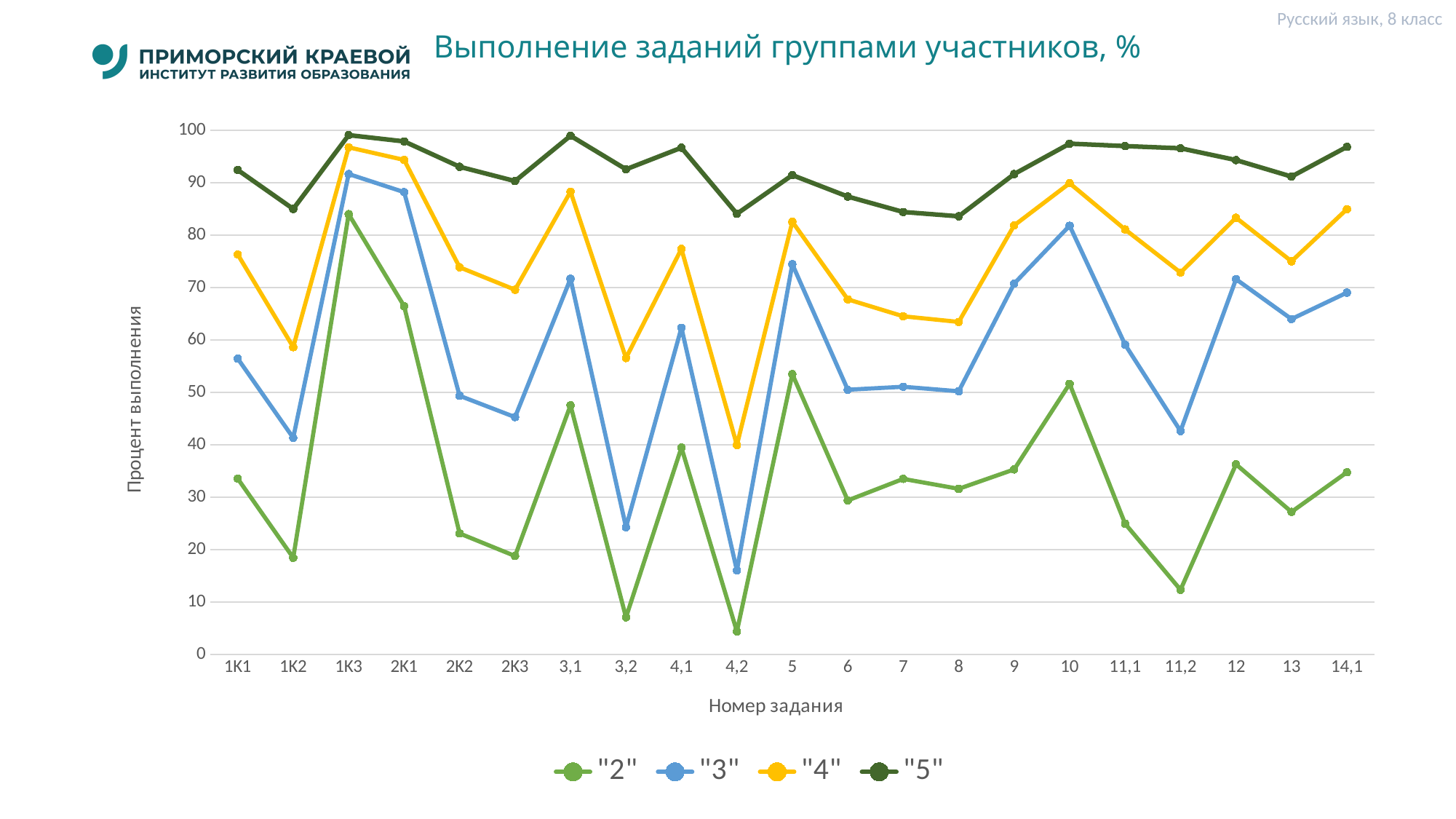
Which series is plotted in yellow? "4" For which task number does the "3" series reach its lowest value? 4,2 Which is larger for the "2" series: the value for task 1К1 or for task 1К2? 1К1 For which task number does the "2" series reach its highest value? 1К3 How many series does the legend list? 4 What kind of chart is shown on the slide? line chart For which task number does the "4" series reach its lowest value? 4,2 Is the value of the "2" series for task 4,2 greater or less than 10? less For which task number does the "2" series reach its lowest value? 4,2 Is the value of the "5" series for task 1К3 greater or less than 90? greater How many task numbers are plotted along the x axis? 21 What is the title of the chart? Выполнение заданий группами участников, %